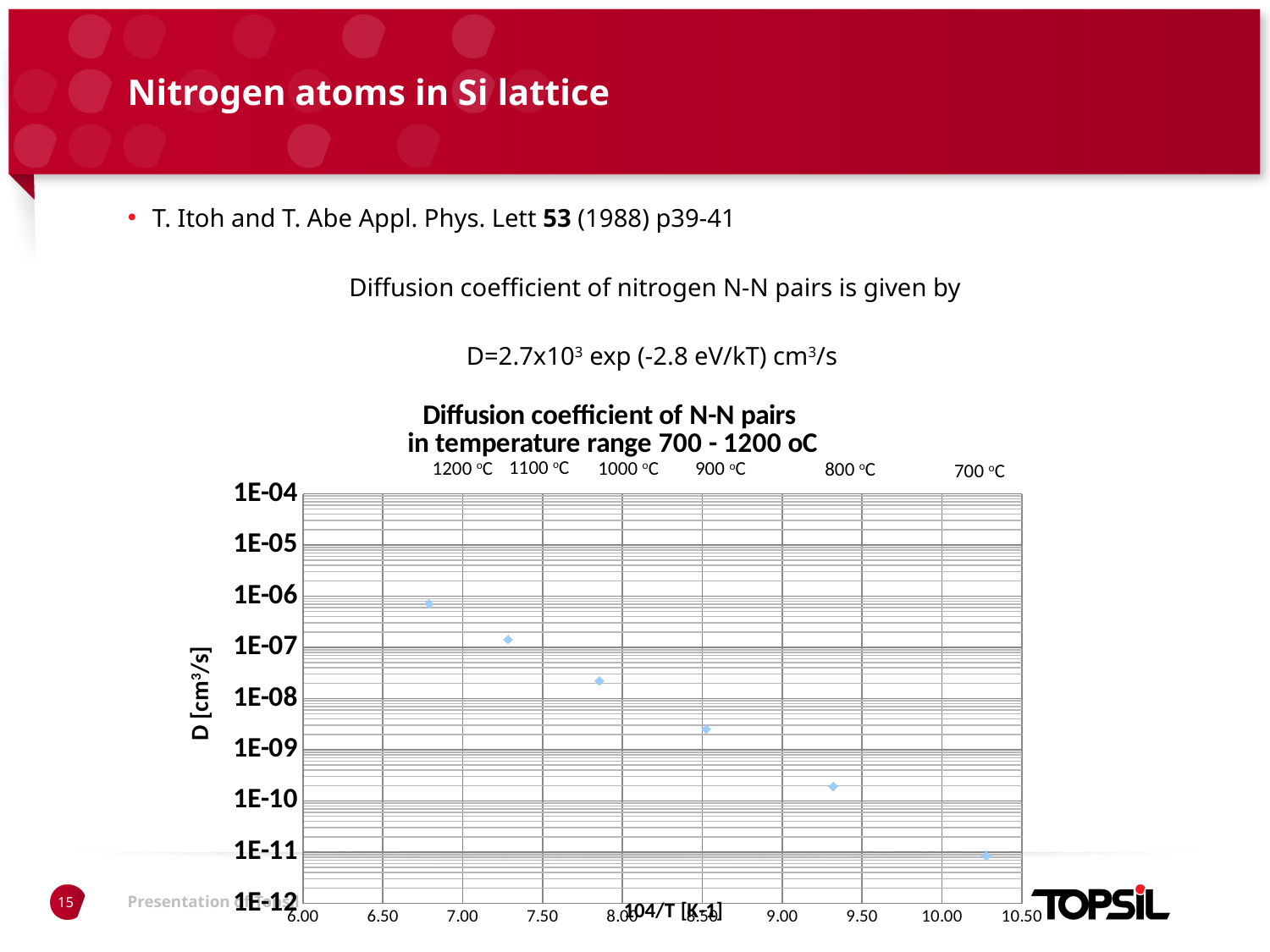
What is the label of the chart's y axis? D [cm³/s] What kind of chart is shown on the slide? scatter chart Is the diffusion coefficient plotted at 1000 °C greater or less than 1E-07? less Which has the larger plotted diffusion coefficient, the point at 1100 °C or the point at 800 °C? 1100 °C Is the diffusion coefficient plotted at 1200 °C greater or less than 1E-07? greater Is the diffusion coefficient plotted at 700 °C greater or less than 1E-10? less At which labelled temperature is the plotted diffusion coefficient highest? 1200 °C What is the title of the chart? Diffusion coefficient of N-N pairs in temperature range 700 - 1200 oC At which labelled temperature is the plotted diffusion coefficient lowest? 700 °C How many data points are plotted in the chart? 6 Do the plotted diffusion coefficient values rise or fall as 10^4/T increases along the x axis? fall